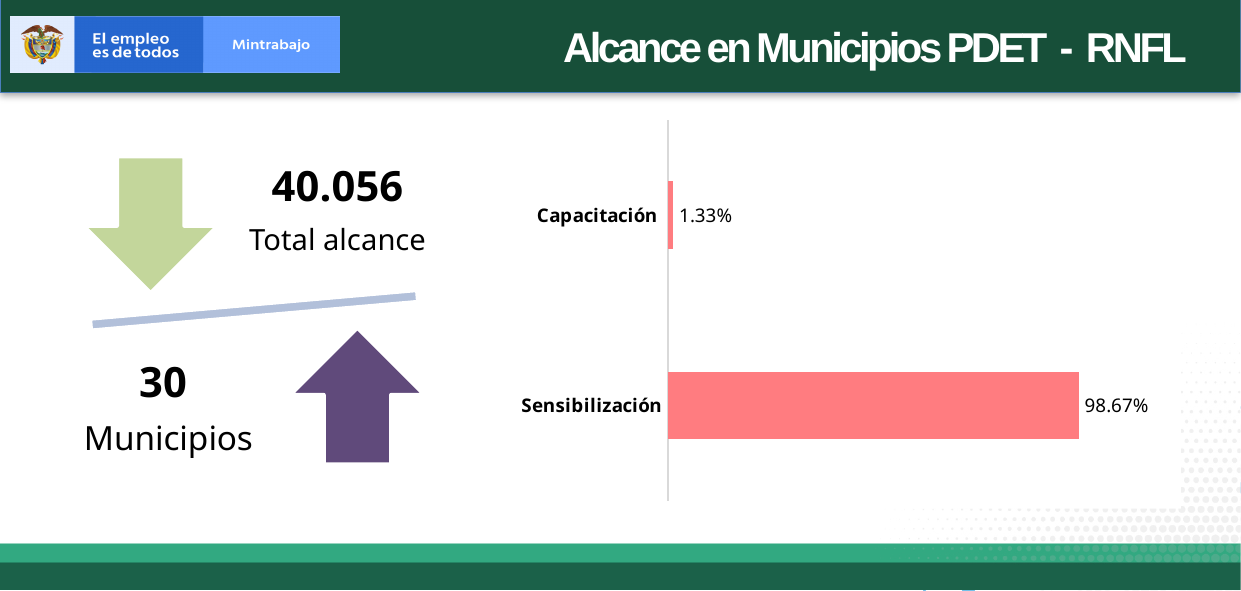
What is the total of the two values shown in the chart? 100% Which category has the lowest value? Capacitación What is the value for Capacitación? 1.33% What is the difference between the values for Sensibilización and Capacitación? 97.34% What colour are the bars in the chart? Salmon pink (light red) Which is larger, the value for Capacitación or the value for Sensibilización? Sensibilización How many categories are shown in the chart? 2 What kind of chart is shown on the slide? Bar chart What is the title of the slide containing the chart? Alcance en Municipios PDET - RNFL Which category has the highest value? Sensibilización What is the value for Sensibilización? 98.67%